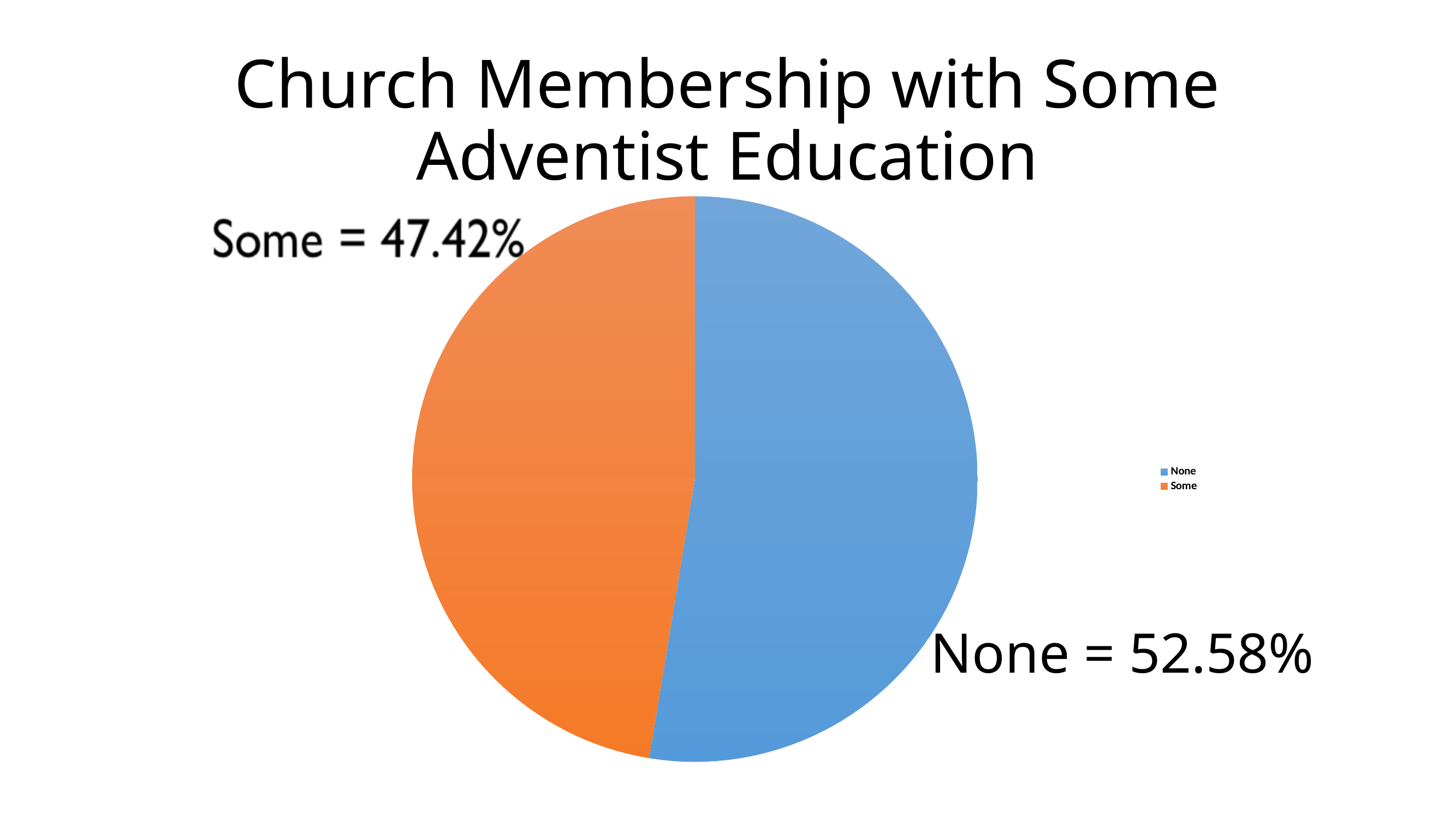
Which slice of the pie is the largest? None What kind of chart is shown on the slide? pie chart Which slice of the pie is the smallest? Some What is the title of the chart? Church Membership with Some Adventist Education How many entries does the legend list? 2 How many slices does the pie chart have? 2 What percentage of church membership has some Adventist education (Some)? 47.42% What percentage of church membership has no Adventist education (None)? 52.58% What is the difference in percentage points between the None slice and the Some slice? 5.16 What colour is the None slice? blue Which is larger, the None slice or the Some slice? None